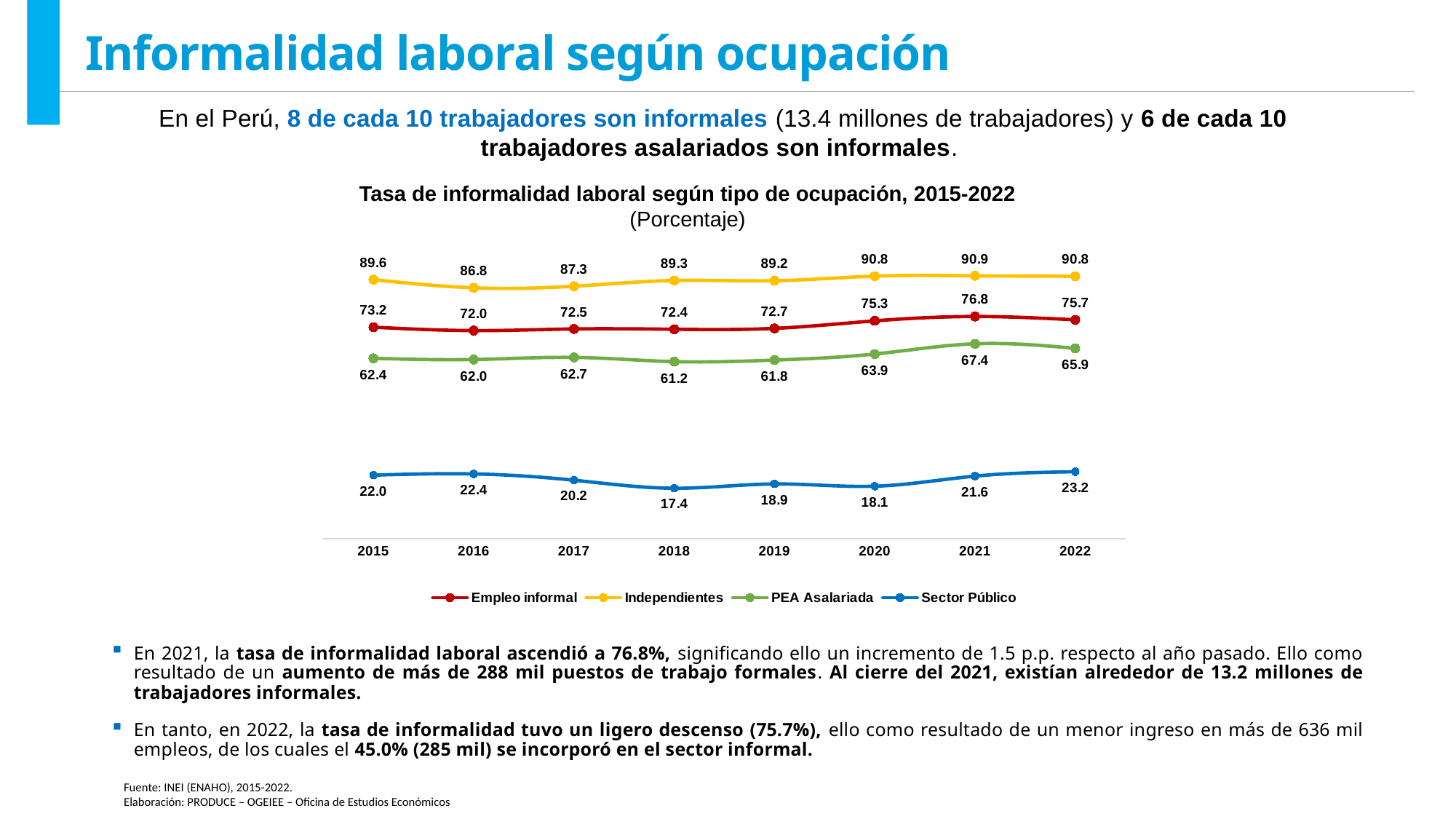
What is the value for Independientes in 2016? 86.8 How many years are shown on the x axis? 8 Which series is drawn in yellow? Independientes How many series does the legend list? 4 In which year is the Sector Público series lowest? 2018 In which year is the Empleo informal series highest? 2021 What is the difference between the Independientes and Sector Público values in 2022? 67.6 Which is larger in 2020: the PEA Asalariada value or the Sector Público value? PEA Asalariada What kind of chart is shown on the slide? Line chart What is the value for Sector Público in 2018? 17.4 What is the value for PEA Asalariada in 2022? 65.9 What is the value for Empleo informal in 2021? 76.8